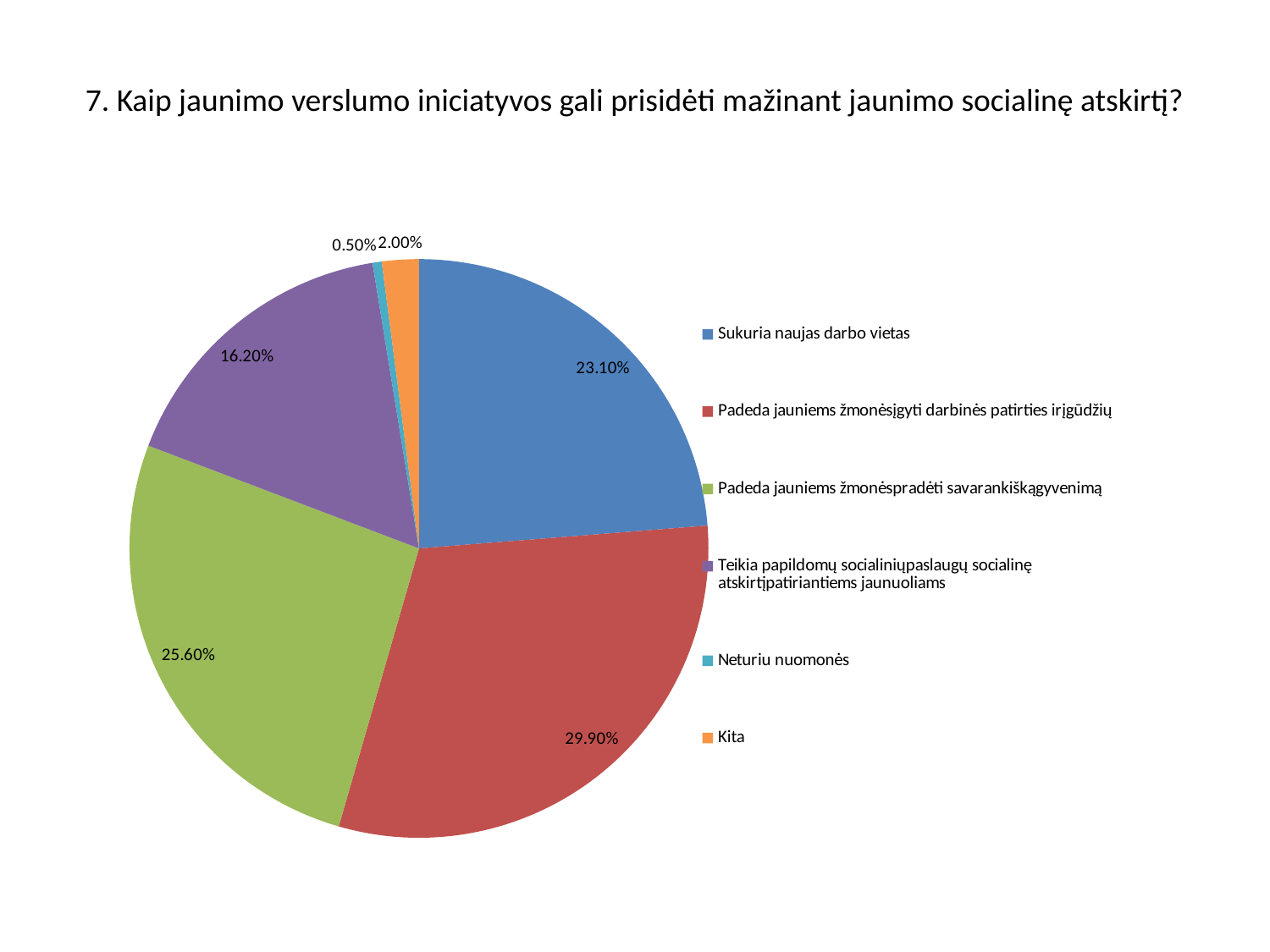
What is the value for "Kita"? 2.00% What share of the pie does "Sukuria naujas darbo vietas" have? 23.10% How many categories does the legend list? 6 What is the value for "Neturiu nuomonės"? 0.50% Which category has the smallest slice of the pie? Neturiu nuomonės What is the value for "Padeda jauniems žmonėms įgyti darbinės patirties ir įgūdžių"? 29.90% Which is larger: the slice for "Sukuria naujas darbo vietas" or the slice for "Teikia papildomų socialinių paslaugų socialinę atskirtį patiriantiems jaunuoliams"? Sukuria naujas darbo vietas What is the value for "Padeda jauniems žmonėms pradėti savarankišką gyvenimą"? 25.60% What kind of chart is shown on the slide? pie chart Which category has the largest slice of the pie? Padeda jauniems žmonėms įgyti darbinės patirties ir įgūdžių What is the difference between the values for "Padeda jauniems žmonėms įgyti darbinės patirties ir įgūdžių" and "Sukuria naujas darbo vietas"? 6.80% What colour is the slice for "Kita"? orange